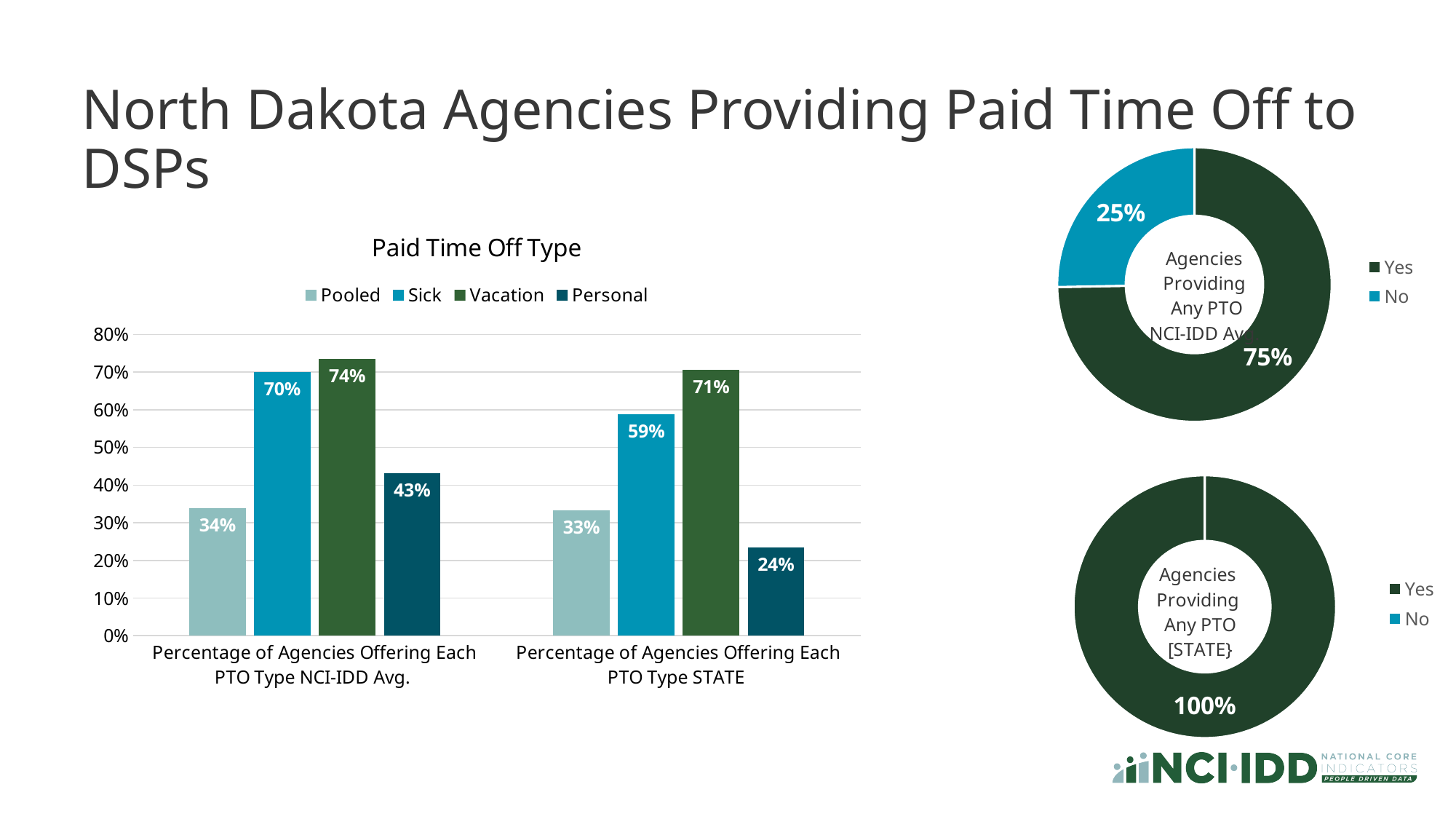
In the 'Paid Time Off Type' bar chart, which PTO type has the lowest value in the STATE group? Personal How many series does the legend of the 'Paid Time Off Type' bar chart list? 4 In the 'Paid Time Off Type' bar chart, which PTO type has the highest value in the STATE group? Vacation In the bottom-right donut chart 'Agencies Providing Any PTO [STATE}', what share is labelled Yes? 100% In the 'Paid Time Off Type' bar chart, what is the value for Personal in the 'Percentage of Agencies Offering Each PTO Type NCI-IDD Avg.' group? 43% In the 'Paid Time Off Type' bar chart, what is the difference between the Sick values for the NCI-IDD Avg. group and the STATE group? 11% In the 'Paid Time Off Type' bar chart, what is the value for Sick in the 'Percentage of Agencies Offering Each PTO Type STATE' group? 59% What kind of chart is the 'Paid Time Off Type' chart? Bar chart In the 'Paid Time Off Type' bar chart, which is larger: Personal for NCI-IDD Avg. or Personal for STATE? Personal for NCI-IDD Avg. In the 'Paid Time Off Type' bar chart, what colour represents the Pooled series? Light teal In the top-right donut chart 'Agencies Providing Any PTO NCI-IDD Avg', what share is labelled No? 25% In the top-right donut chart 'Agencies Providing Any PTO NCI-IDD Avg', what is the difference between the Yes and No shares? 50%